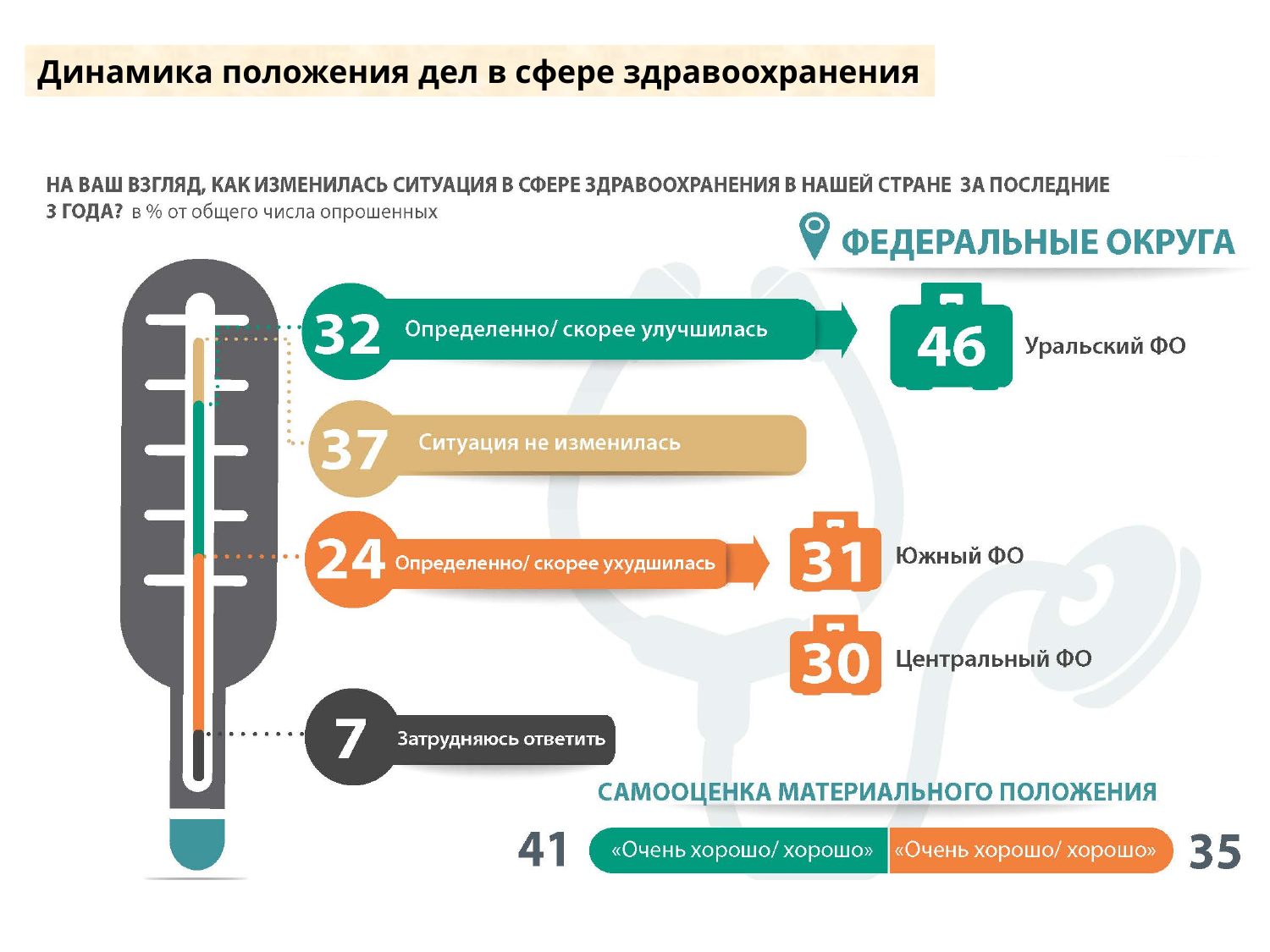
In the Федеральные округа section, which district has the larger value: Южный ФО or Центральный ФО? Южный ФО What percentage of respondents said the healthcare situation definitely/rather worsened (Определенно/ скорее ухудшилась)? 24 What percentage of respondents found it difficult to answer (Затрудняюсь ответить)? 7 What percentage of respondents said the healthcare situation definitely/rather improved (Определенно/ скорее улучшилась)? 32 In the Самооценка материального положения section, what is the difference between the green value and the orange value? 6 What is the difference between the share who said the situation did not change and the share who said it improved? 5 In the Федеральные округа section, what value is shown for Уральский ФО? 46 Which answer option has the highest share of respondents in the thermometer infographic? Ситуация не изменилась In the Самооценка материального положения section, what value is shown next to the green «Очень хорошо/ хорошо» label? 41 How many answer options are shown on the thermometer infographic? 4 What percentage of respondents said the situation did not change (Ситуация не изменилась)? 37 Which answer option has the lowest share of respondents in the thermometer infographic? Затрудняюсь ответить